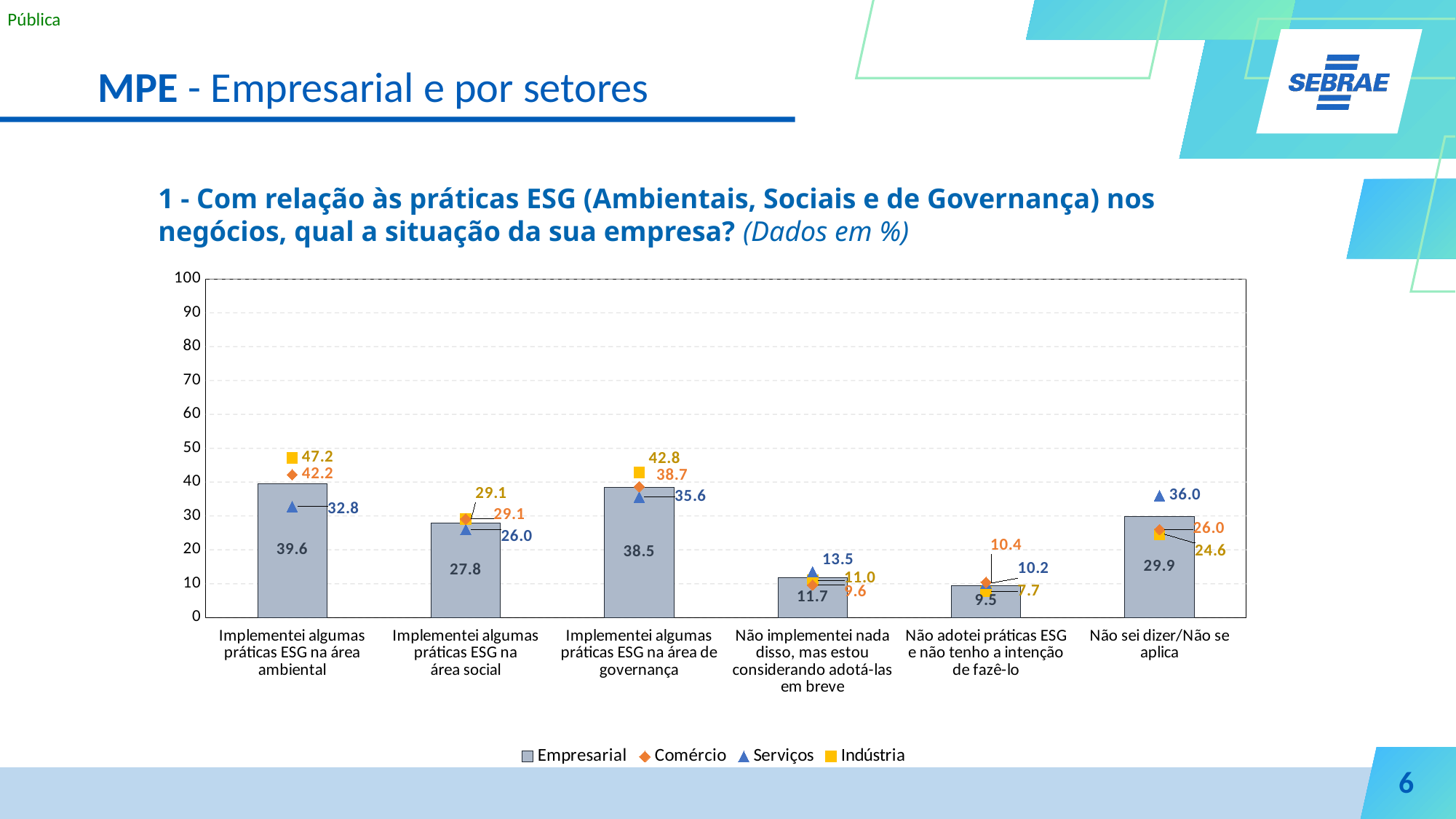
What is the difference between the Indústria and Serviços values for "Implementei algumas práticas ESG na área ambiental"? 14.4 Which category has the highest Empresarial value? Implementei algumas práticas ESG na área ambiental What is the Comércio value for "Não adotei práticas ESG e não tenho a intenção de fazê-lo"? 10.4 What is the Empresarial value for "Implementei algumas práticas ESG na área ambiental"? 39.6 Which series is shown with a yellow square marker in the legend? Indústria How many categories are shown on the x axis? 6 Which category has the lowest Empresarial value? Não adotei práticas ESG e não tenho a intenção de fazê-lo What is the Indústria value for "Implementei algumas práticas ESG na área de governança"? 42.8 For "Não implementei nada disso, mas estou considerando adotá-las em breve", which is larger: the Serviços value or the Comércio value? Serviços What kind of chart is used for the Empresarial series? Bar chart What is the Serviços value for "Não sei dizer/Não se aplica"? 36.0 How many series does the legend list? 4